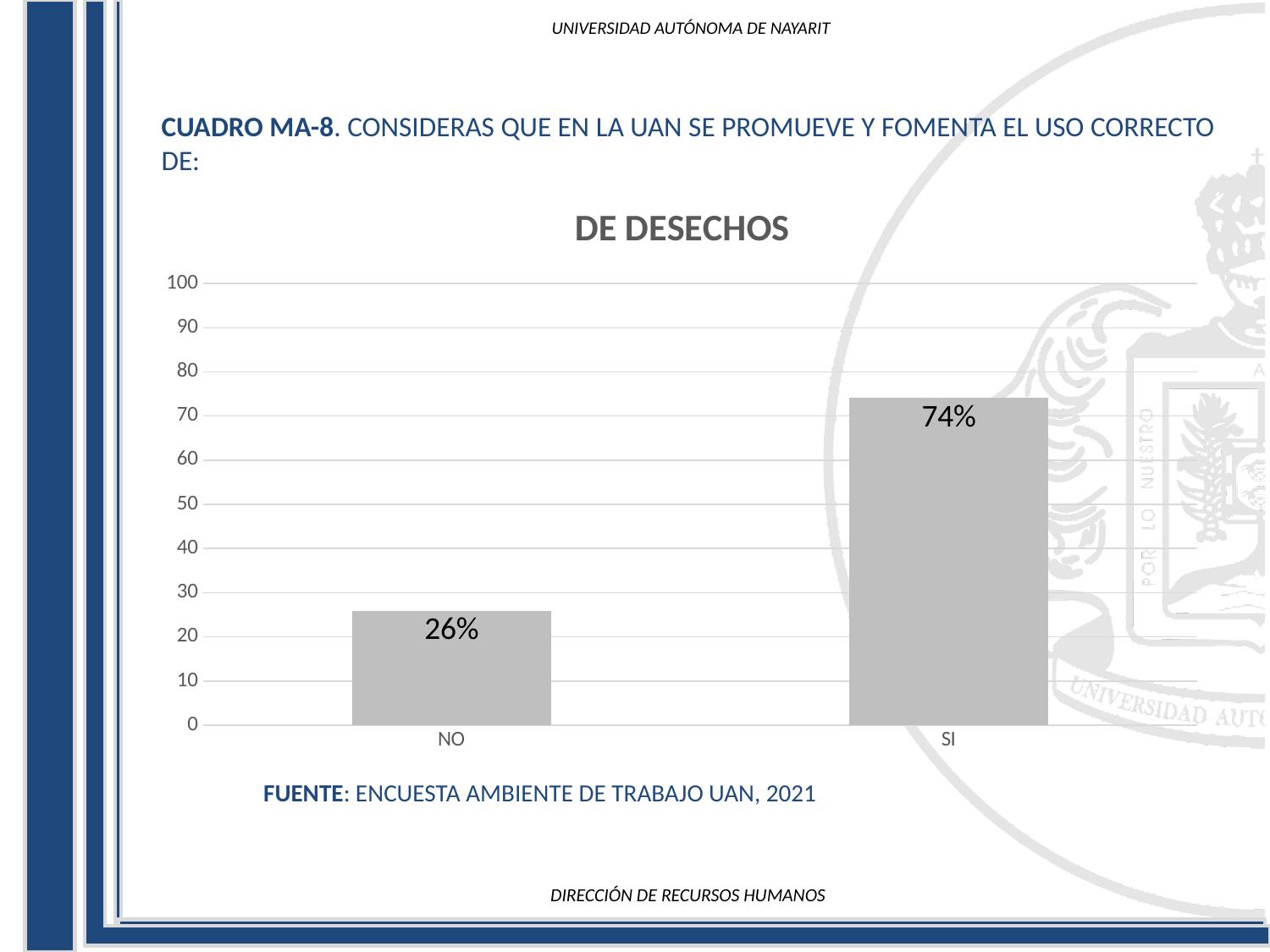
What is the highest value shown on the y axis? 100 What is the value for NO? 26% What is the title of the chart? DE DESECHOS Is the value for NO greater or less than 30? less What is the value for SI? 74% What kind of chart is shown on the slide? bar chart How many categories are shown on the x axis? 2 Which category has the lowest value? NO Which category has the highest value? SI What is the difference between the values for SI and NO? 48% Which is larger, the value for NO or the value for SI? SI Is the value for SI greater or less than 70? greater